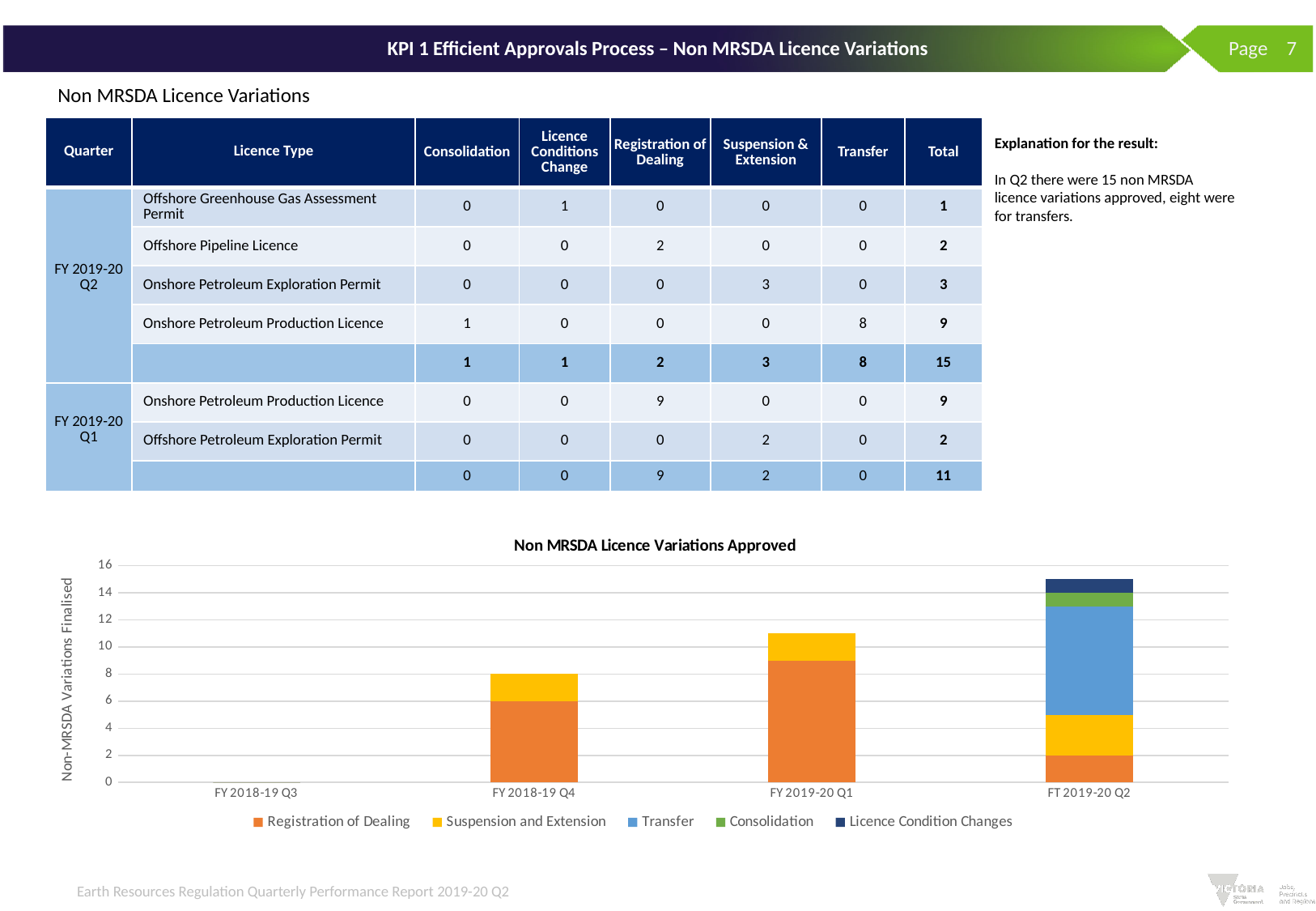
What is the total height of the stacked bar for FY 2018-19 Q4? 8 Which is larger, the total for FY 2019-20 Q1 or the total for FY 2018-19 Q4? FY 2019-20 Q1 Do the total variations rise or fall across the quarters from left to right? Rise Which quarter has the lowest total in the chart? FY 2018-19 Q3 Is the total for FY 2019-20 Q1 greater or less than 10? greater How many quarters are shown on the x axis of the chart? 4 Is the total for FT 2019-20 Q2 greater or less than 14? greater Which quarter has the tallest stacked bar in the chart? FT 2019-20 Q2 What is the title of the chart? Non MRSDA Licence Variations Approved How many series does the chart legend list? 5 What is the value of Registration of Dealing for FY 2018-19 Q4? 6 What kind of chart is shown on the slide? Stacked bar chart